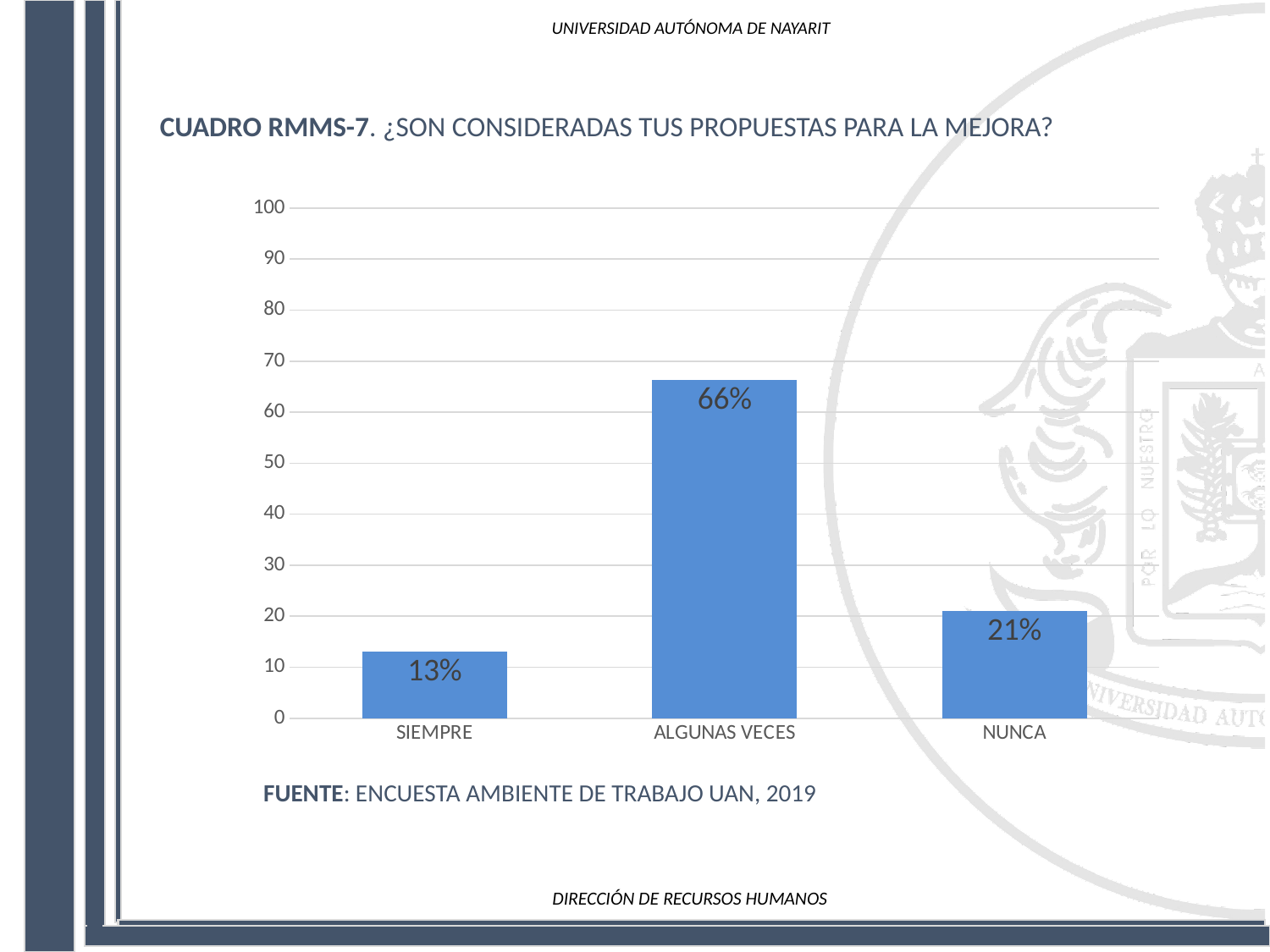
Which category has the highest value? ALGUNAS VECES What kind of chart is shown on the slide? bar chart How many categories are shown on the x axis? 3 What is the difference between the values for NUNCA and SIEMPRE? 8% What is the value for SIEMPRE? 13% Which is larger, the value for NUNCA or the value for SIEMPRE? NUNCA What is the value for ALGUNAS VECES? 66% What is the difference between the values for ALGUNAS VECES and NUNCA? 45% Which category has the lowest value? SIEMPRE What is the value for NUNCA? 21% Is the value for ALGUNAS VECES greater or less than 60? greater What is the source cited below the chart? ENCUESTA AMBIENTE DE TRABAJO UAN, 2019